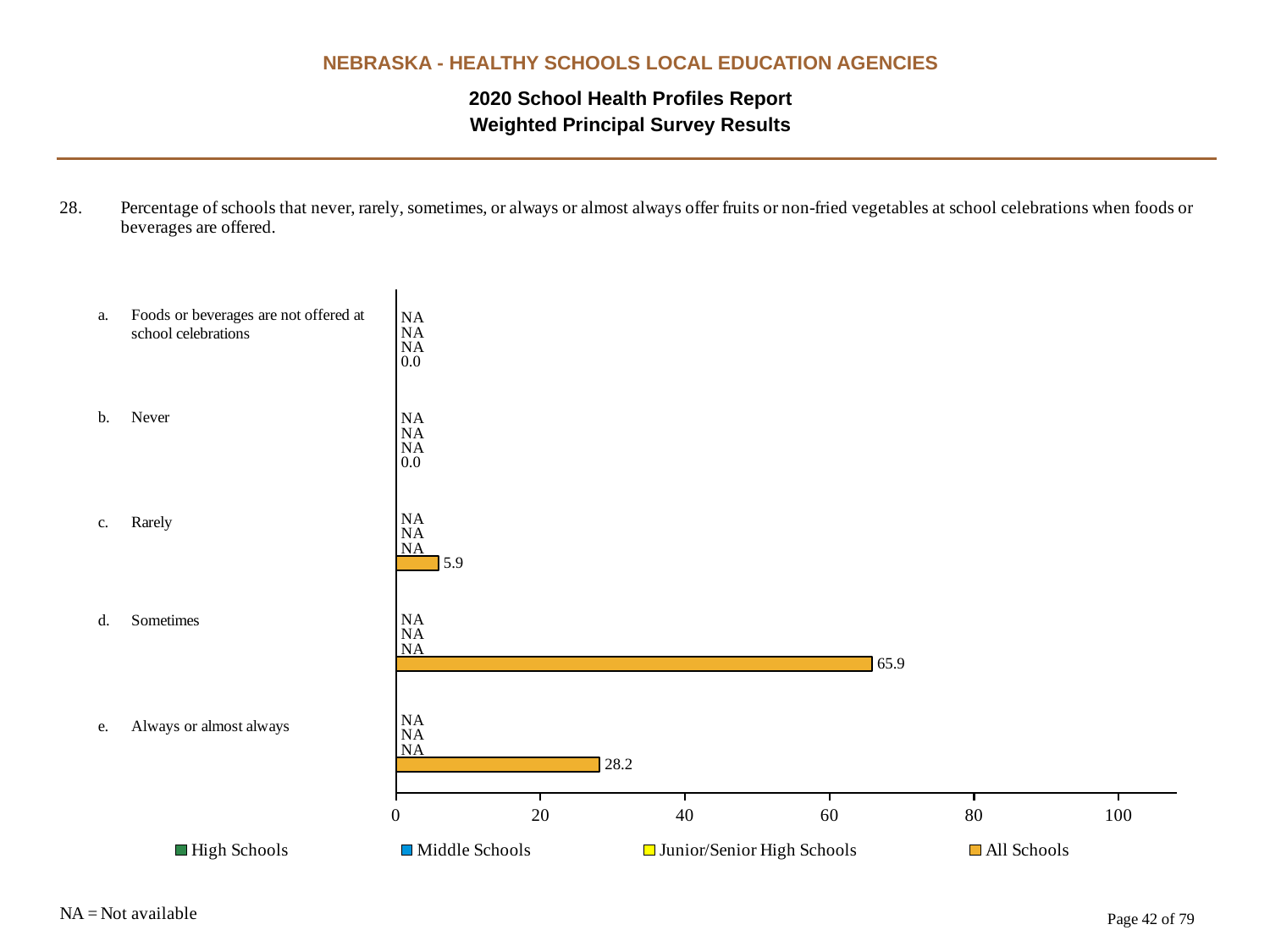
How many response categories are shown on the chart? 5 What is the All Schools value for "Never"? 0.0 Is the All Schools value for "Sometimes" greater or less than 60? greater What is the High Schools value shown for "Sometimes"? NA Which category has the highest All Schools value? Sometimes Which is larger for All Schools: "Rarely" or "Always or almost always"? Always or almost always What is the All Schools value for "Rarely"? 5.9 What kind of chart is shown on the slide? bar chart How many series does the legend list? 4 What is the All Schools value for "Sometimes"? 65.9 What is the difference between the All Schools values for "Sometimes" and "Always or almost always"? 37.7 What is the All Schools value for "Always or almost always"? 28.2